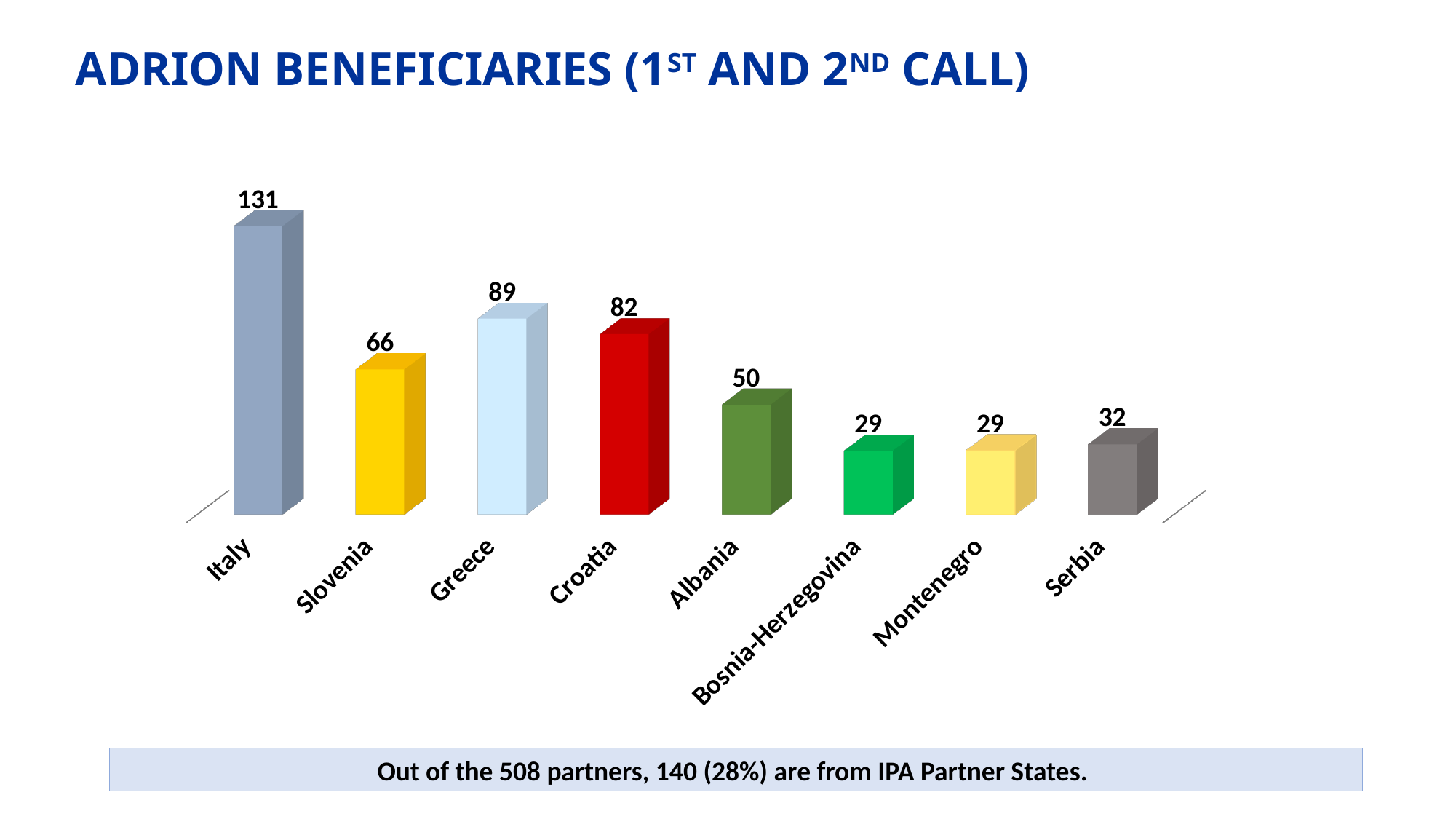
What is the value for Bosnia-Herzegovina? 29 What is the value for Serbia? 32 What is the value for Greece? 89 What kind of chart is shown on the slide? bar chart Which country has the highest value? Italy What is the value for Italy? 131 What is the difference between the values for Italy and Croatia? 49 What is the title of the slide? ADRION BENEFICIARIES (1ST AND 2ND CALL) Which is larger, the value for Croatia or the value for Greece? Greece Which is larger, the value for Albania or the value for Serbia? Albania How many countries are shown on the chart? 8 What is the difference between the values for Greece and Slovenia? 23